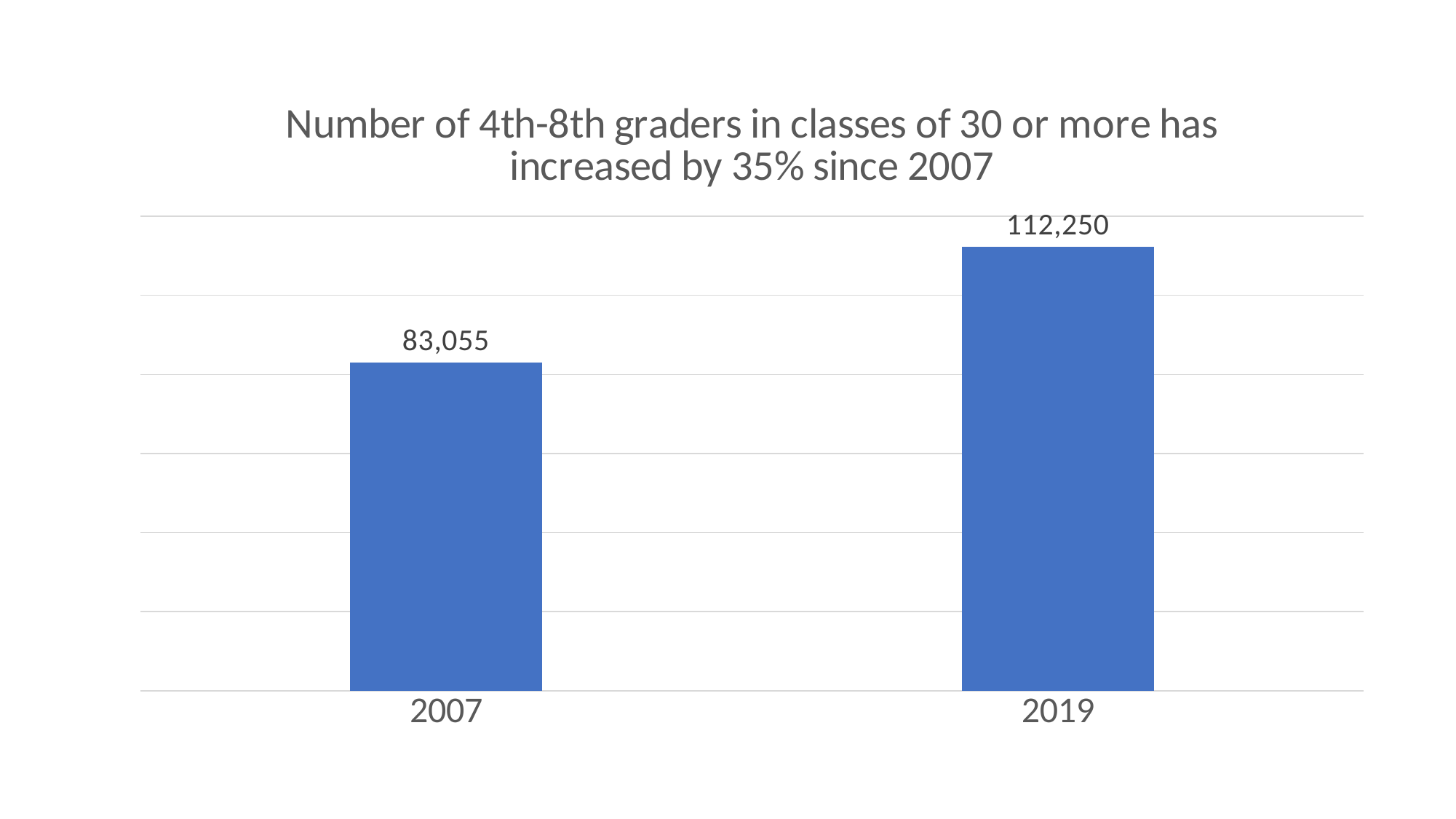
By what percentage does the chart title say the number has increased since 2007? 35% What kind of chart is shown on the slide? Bar chart What is the difference between the values for 2019 and 2007? 29,195 How many bars are shown in the chart? 2 What is the value for 2019? 112,250 Do the values rise or fall from 2007 to 2019? Rise Which year has the higher value? 2019 What is the title of the chart? Number of 4th-8th graders in classes of 30 or more has increased by 35% since 2007 What is the value for 2007? 83,055 What colour are the bars in the chart? Blue Which year has the lower value? 2007 Is the value for 2019 larger than the value for 2007? Yes